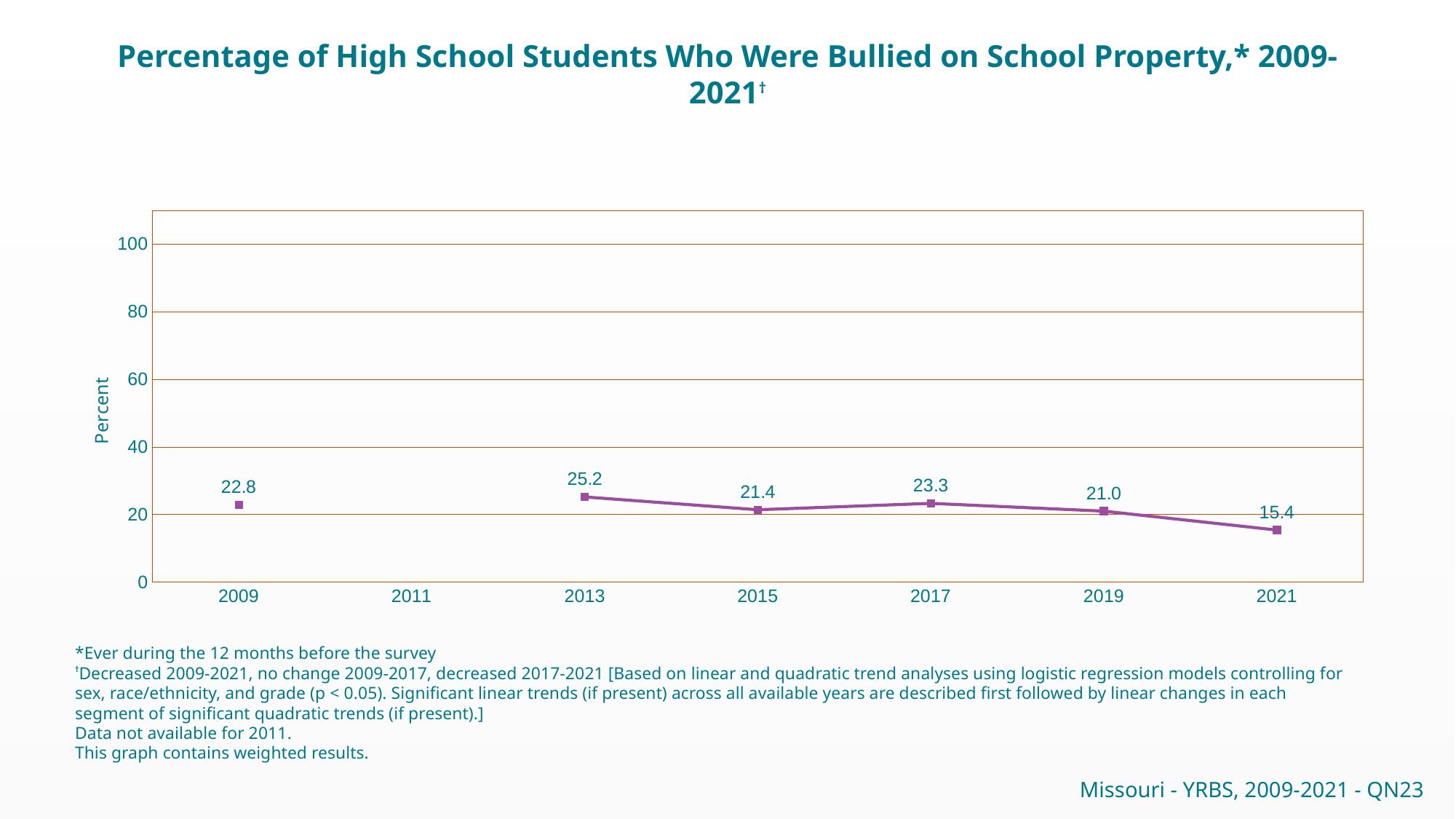
Does the value rise or fall from 2019 to 2021? fall What is the label on the y axis? Percent What is the value plotted for 2009? 22.8 What percentage of high school students were bullied on school property in 2013? 25.2 What is the difference between the 2013 value and the 2021 value? 9.8 Which year has the lowest percentage of students bullied on school property? 2021 Which year has the highest percentage of students bullied on school property? 2013 How many data points are plotted on the chart? 6 What kind of chart is shown on the slide? line chart What is the value plotted for 2021? 15.4 Is the value for 2021 greater or less than 20? less Which year has a higher value, 2017 or 2019? 2017